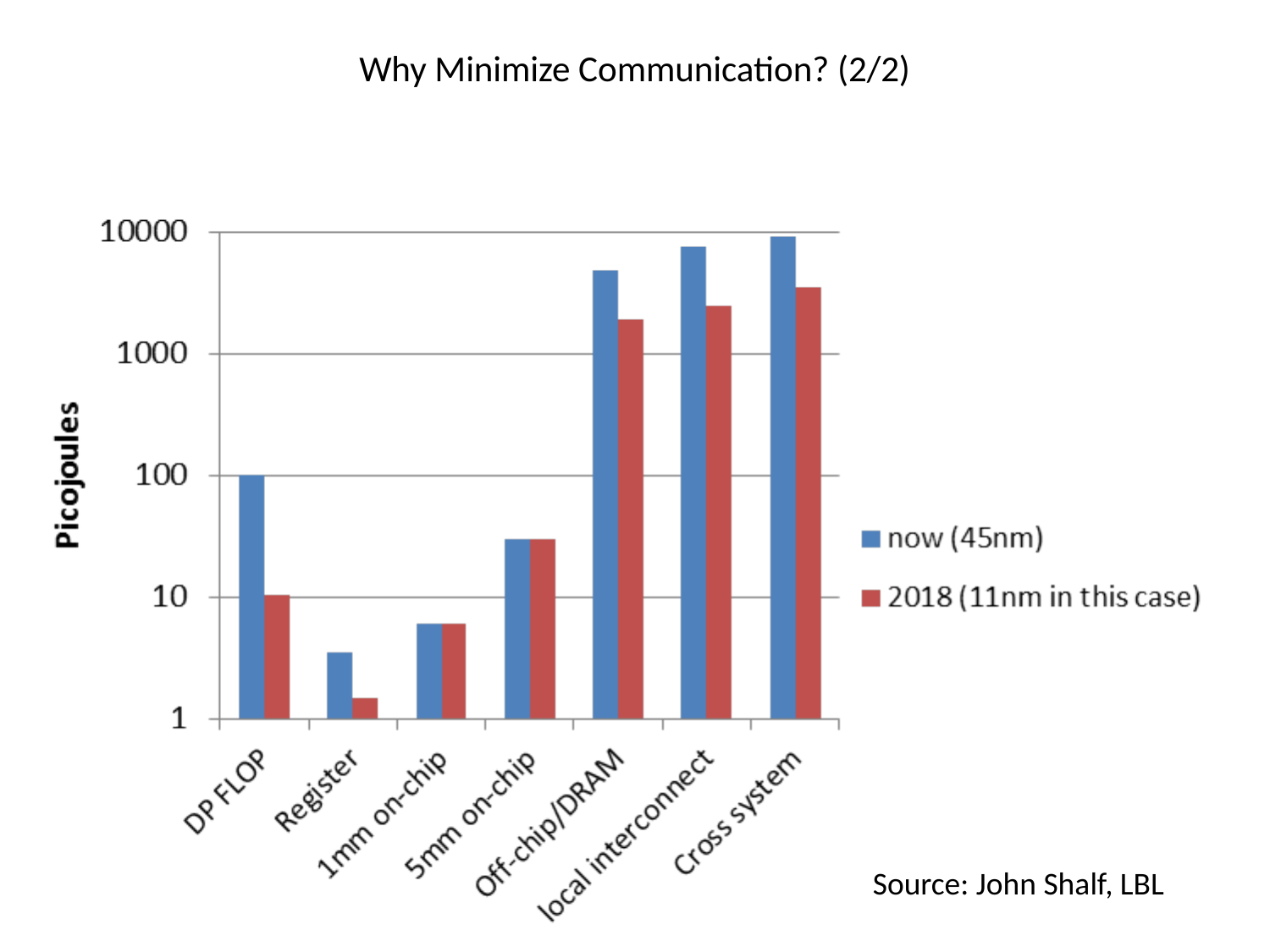
What is the label of the y axis of the chart? Picojoules How many categories are shown on the x axis of the chart? 7 For DP FLOP, which series has the larger value, now (45nm) or 2018 (11nm in this case)? now (45nm) Is the now (45nm) value for Cross system greater or less than 1000? greater Which category has the lowest value for the 2018 (11nm in this case) series? Register Which category has the lowest value for the now (45nm) series? Register How many series does the chart's legend list? 2 What type of chart is shown on the slide? Bar chart What are the two series named in the chart's legend? now (45nm) and 2018 (11nm in this case) Is the 2018 (11nm in this case) value for Off-chip/DRAM greater or less than 1000? greater Is the now (45nm) value for Register greater or less than 10? less Which category has the highest value for the now (45nm) series? Cross system